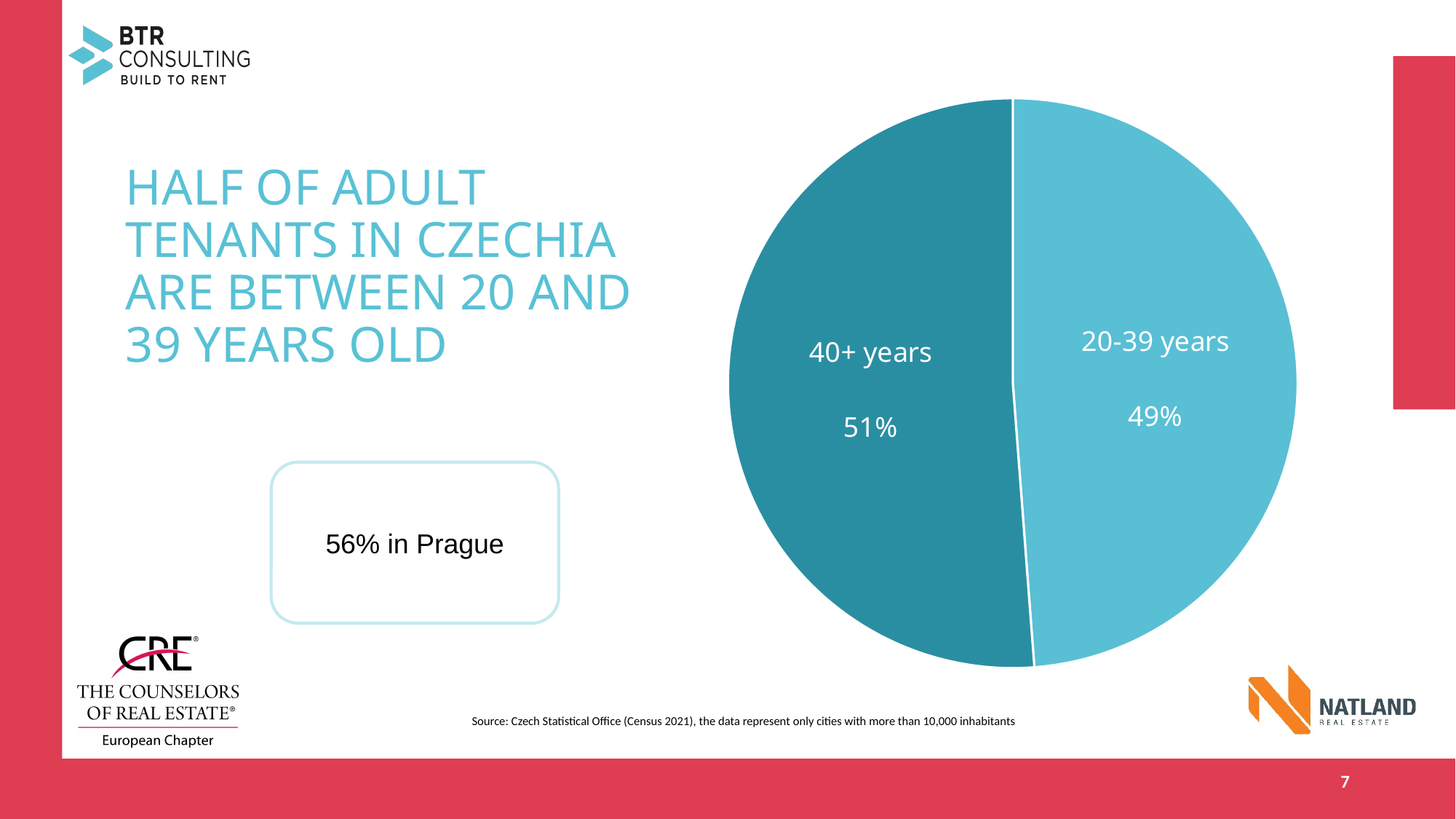
What share of adult tenants are in the 40+ years group according to the pie chart? 51% How many slices does the pie chart have? 2 What is the combined share of the two slices in the pie chart? 100% What share of adult tenants are in the 20-39 years group according to the pie chart? 49% Which age group has the smaller share in the pie chart? 20-39 years Is the share for 40+ years greater or less than 50%? greater Is the share for 20-39 years greater or less than 50%? less What is the difference in percentage points between the 40+ years share and the 20-39 years share? 2 percentage points According to the text box on the slide, what is the share of 20-39 year old tenants in Prague? 56% Which age group has the larger share in the pie chart? 40+ years What kind of chart is shown on the slide? Pie chart Which slice of the pie chart is shown in the darker teal colour? 40+ years